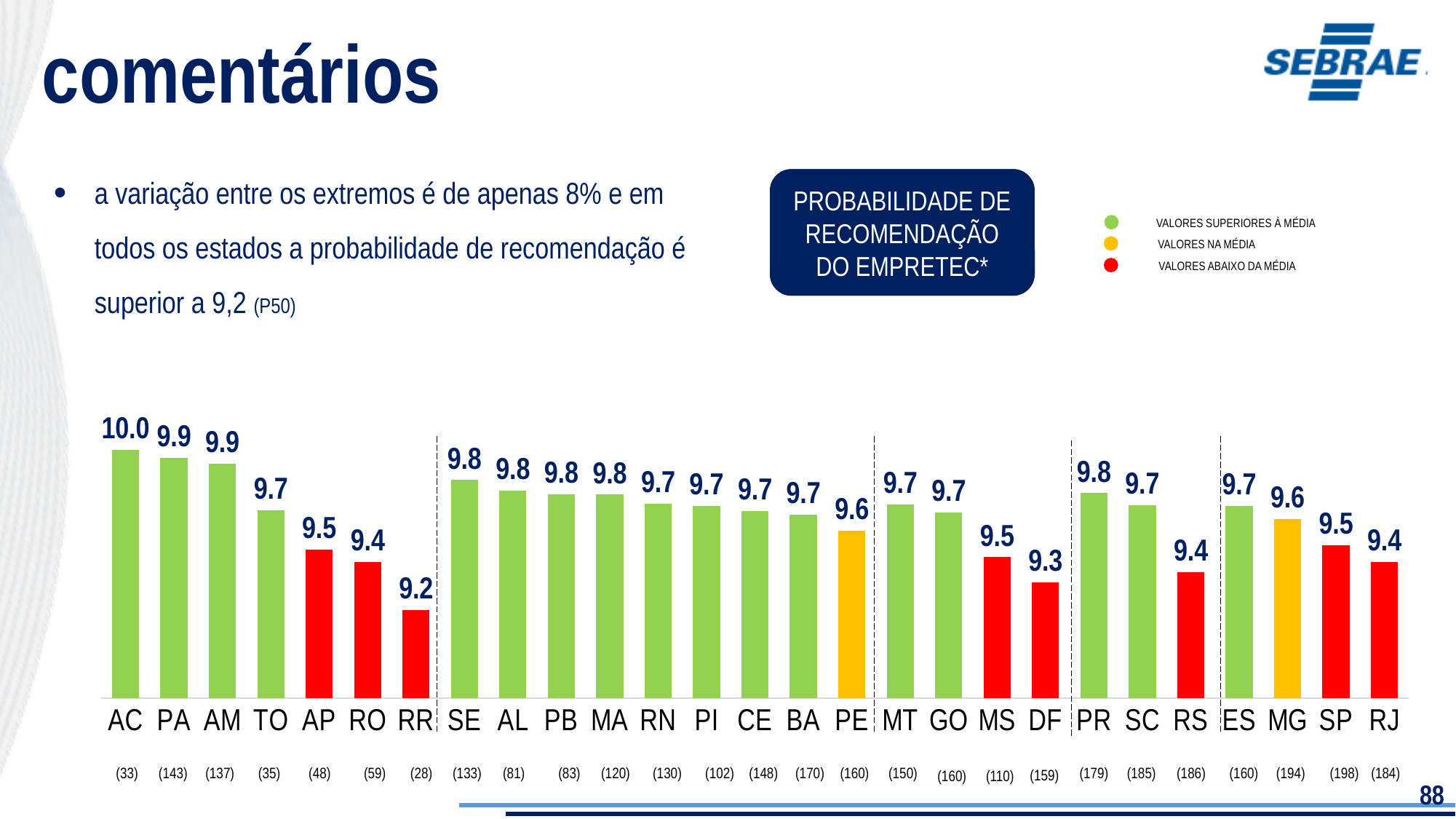
Which is larger, the value for TO or the value for AP? TO What is the value for DF? 9.3 What is the value for RS? 9.4 What is the difference between the values for PR and DF? 0.5 What is the value for PE? 9.6 What is the value for AC? 10.0 Which state has the highest value? AC What kind of chart is this? Bar chart Which state has the lowest value? RR How many states are shown on the x axis? 27 Which two states have yellow bars (valores na média)? PE and MG What is the difference between the values for AC and RR? 0.8